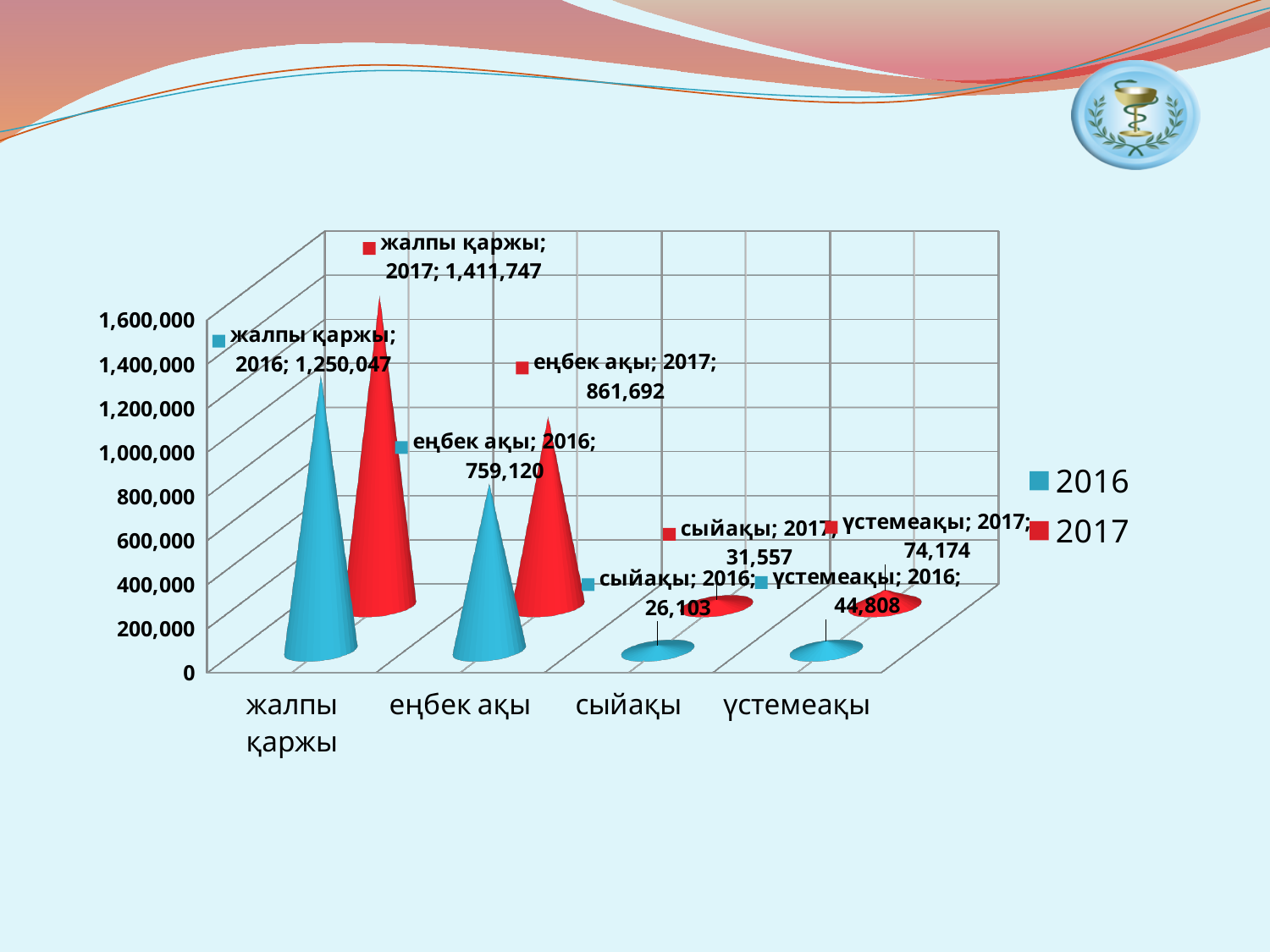
Which category has the highest value in the 2016 series? жалпы қаржы What is the difference between the 2017 and 2016 values for жалпы қаржы? 161,700 What is the difference between the 2017 and 2016 values for үстемеақы? 29,366 What is the value for сыйақы in 2017? 31,557 What is the value for еңбек ақы in 2016? 759,120 How many series does the legend list? 2 What is the value for үстемеақы in 2016? 44,808 What kind of chart is shown on the slide? bar chart Which is larger: еңбек ақы in 2016 or еңбек ақы in 2017? еңбек ақы in 2017 What is the value for жалпы қаржы in 2017? 1,411,747 How many categories are shown on the x axis? 4 Which category has the lowest value in the 2017 series? сыйақы